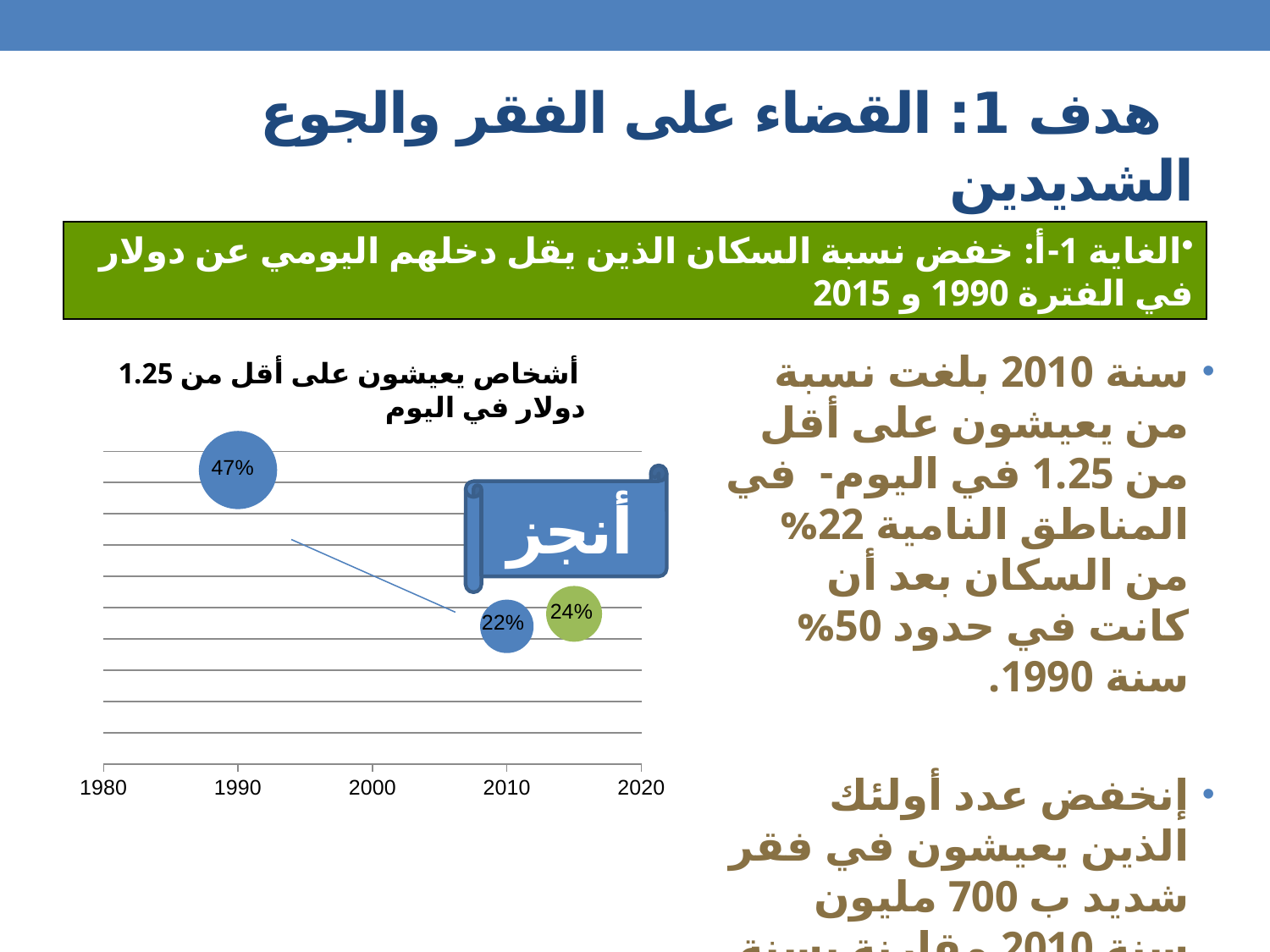
What is the value shown for the blue bubble at 2010? 22% What kind of chart is shown on the slide? Bubble chart What is the first year label on the x axis? 1980 How many data bubbles are plotted on the chart? 3 By how many percentage points does the 1990 value exceed the 2010 blue bubble value? 25 Which is larger, the value for 1990 or the value for 2010? 1990 What is the value shown for the bubble at 1990? 47% What is the lowest value labelled on the chart? 22% Do the values rise or fall from 1990 to 2010? Fall What is the last year label on the x axis? 2020 Which year has the highest labelled value in the chart? 1990 What value is printed on the green bubble? 24%